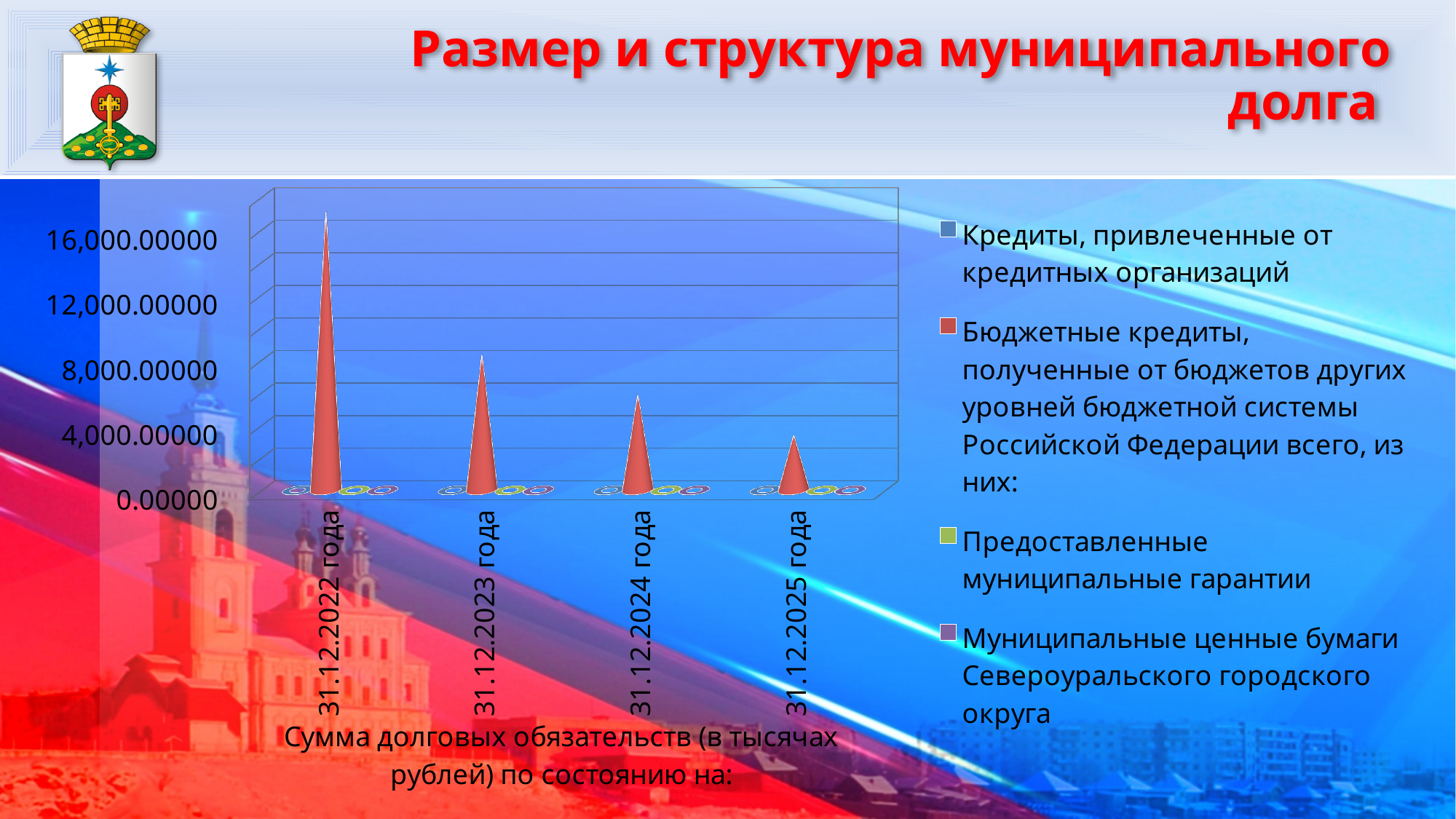
Is the value for budget credits on 31.12.2024 года greater or less than 8,000? less Is the value for budget credits on 31.12.2025 года greater or less than 8,000? less What kind of chart is shown on the slide? bar chart On which date is the value for 'Бюджетные кредиты, полученные от бюджетов других уровней бюджетной системы Российской Федерации всего, из них:' the lowest? 31.12.2025 года How many dates are shown along the x axis of the chart? 4 Do the values for budget credits rise or fall from 31.12.2022 года to 31.12.2025 года? fall What is the title of the x axis of the chart? Сумма долговых обязательств (в тысячах рублей) по состоянию на: How many series does the chart legend list? 4 Which is larger: the budget credits value on 31.12.2022 года or on 31.12.2023 года? 31.12.2022 года Is the value for budget credits on 31.12.2024 года greater or less than 4,000? greater On which date is the value for 'Бюджетные кредиты, полученные от бюджетов других уровней бюджетной системы Российской Федерации всего, из них:' the highest? 31.12.2022 года